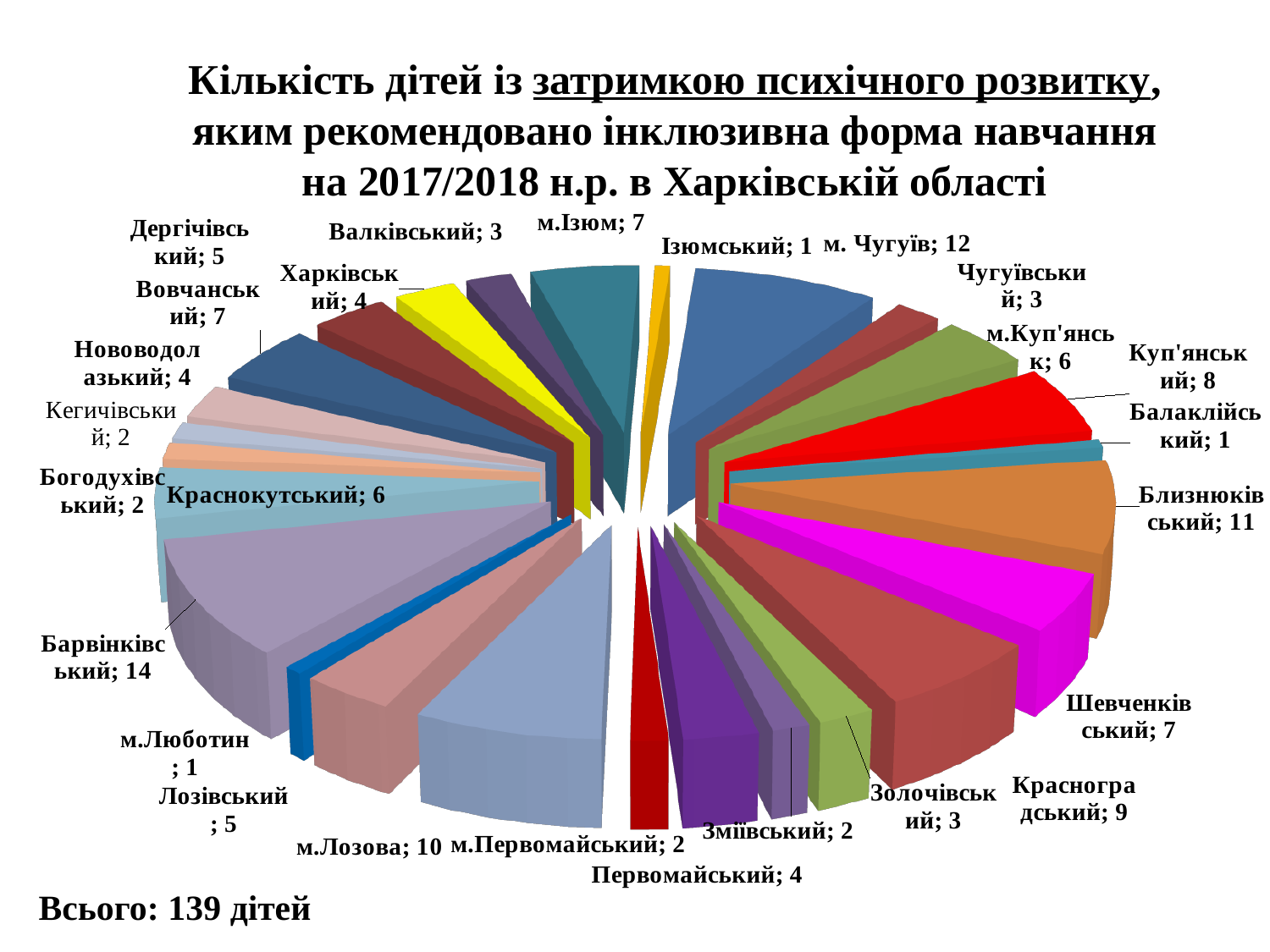
How many categories (districts and cities) are shown in the pie chart? 26 What is the difference between the values for Барвінківський and м. Чугуїв? 2 What total number of children is stated on the slide? 139 What type of chart is shown on the slide? pie chart What is the value for Красноградський? 9 What is the value for м.Лозова? 10 For which school year does the chart show data? 2017/2018 Which category has the largest slice in the pie chart? Барвінківський What is the value for м. Чугуїв? 12 How many children with delayed mental development are shown for Барвінківський? 14 Which is larger, the value for Куп'янський or the value for м.Куп'янськ? Куп'янський What is the value for Близнюківський? 11